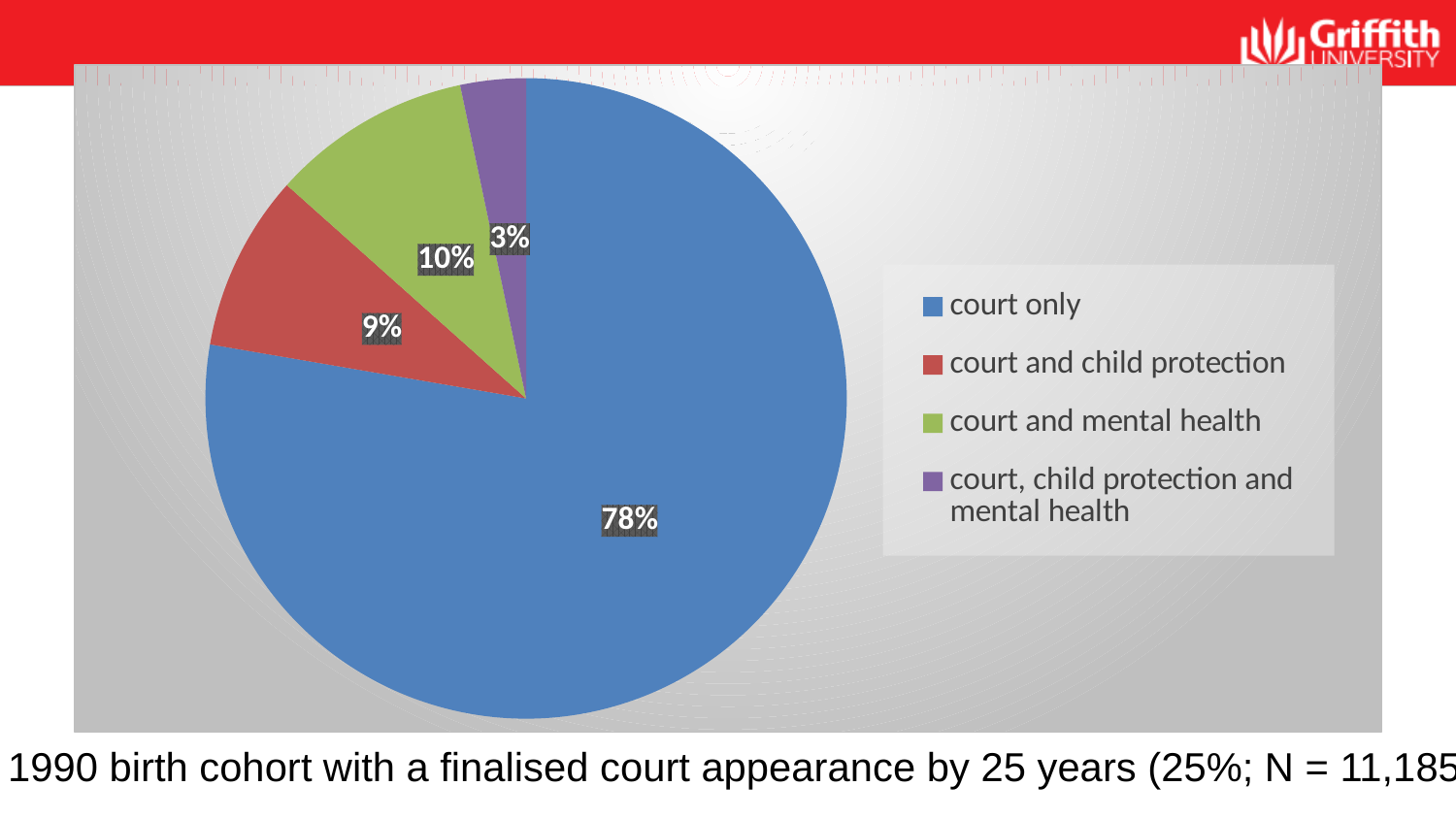
How many categories does the legend list? 4 Which category has the largest share of the pie? court only Which category has the smallest share of the pie? court, child protection and mental health Which is larger: 'court and mental health' or 'court and child protection'? court and mental health What colour is the 'court and mental health' slice? green What percentage of the pie is 'court, child protection and mental health'? 3% What percentage of the pie is 'court only'? 78% What colour is the 'court only' slice? blue What is the difference in percentage points between 'court only' and 'court and mental health'? 68 What kind of chart is shown on the slide? pie chart What percentage of the pie is 'court and mental health'? 10% What percentage of the pie is 'court and child protection'? 9%